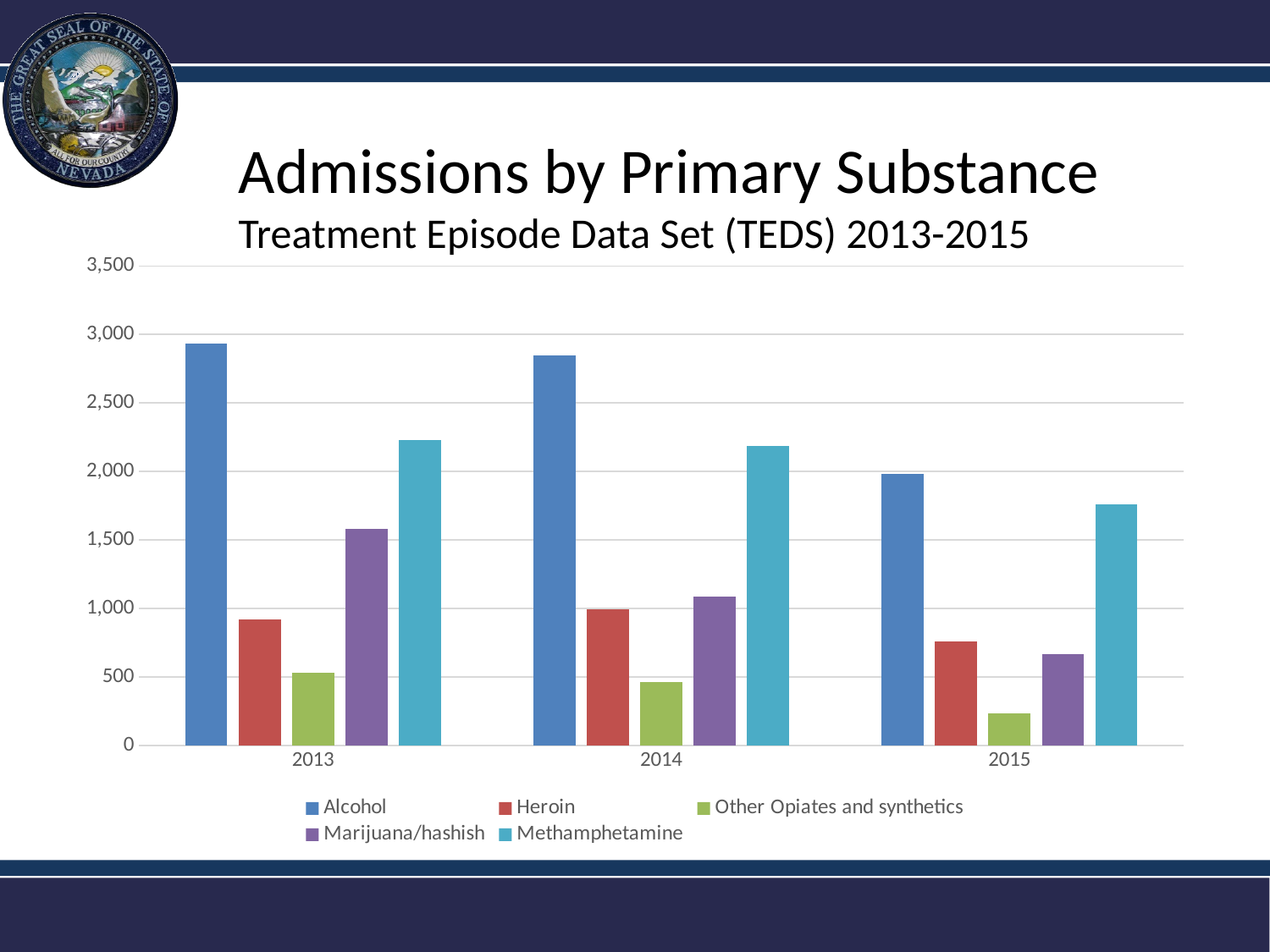
Is the value for Methamphetamine in 2014 greater or less than 2,000? greater Is the value for Alcohol in 2013 greater or less than 2,500? greater Is the value for Other Opiates and synthetics in 2015 greater or less than 500? less What kind of chart is shown on the slide? bar chart Which substance has the highest admissions in 2013? Alcohol How many years are shown on the x axis? 3 What is the title of the chart? Admissions by Primary Substance Which substance has the lowest admissions in 2015? Other Opiates and synthetics Do Alcohol admissions rise or fall from 2013 to 2015? fall In 2014, which is larger: Methamphetamine or Marijuana/hashish? Methamphetamine How many series does the legend list? 5